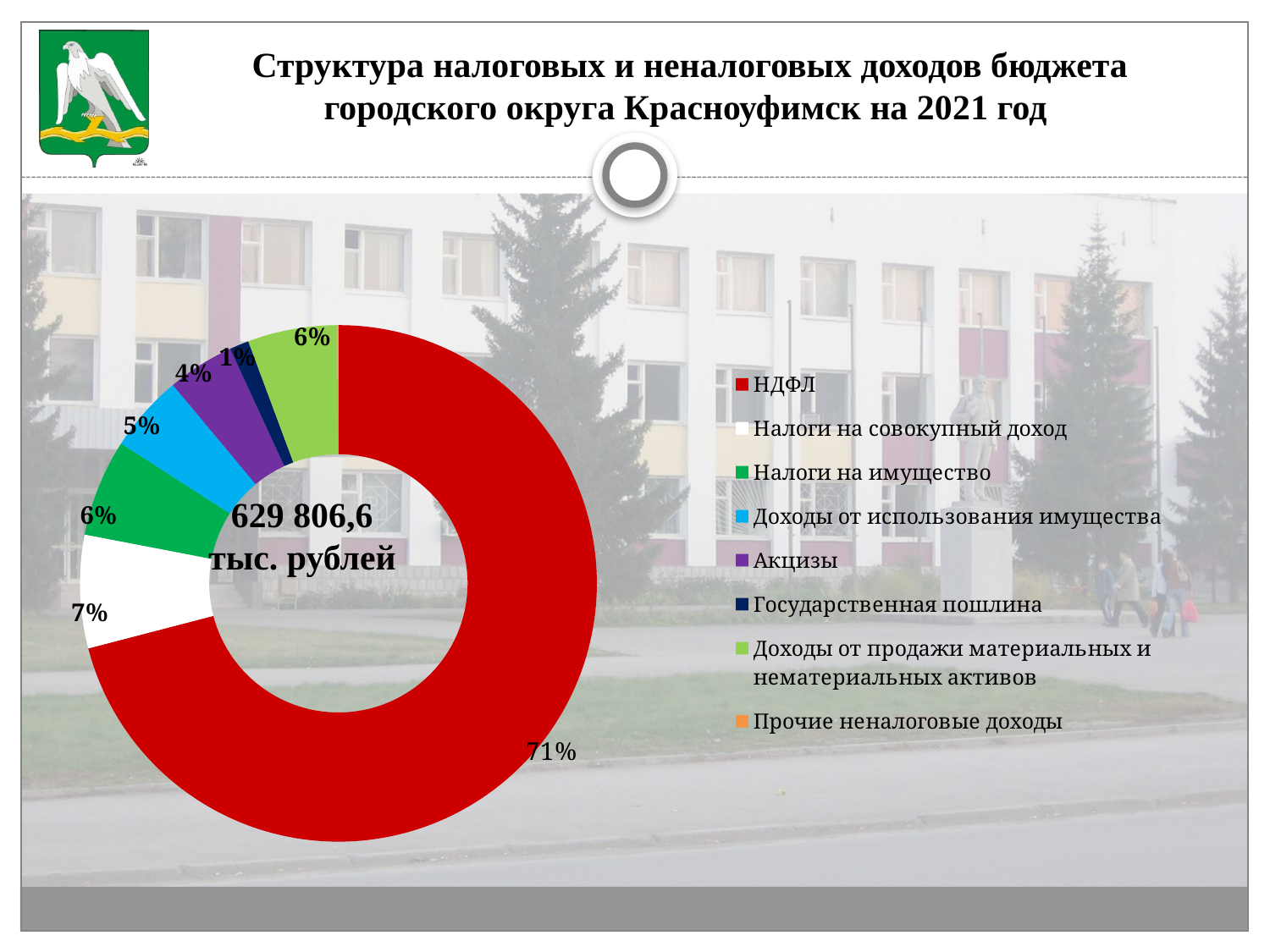
What percentage is shown for Доходы от использования имущества? 5% What share of the chart does НДФЛ account for? 71% Which category has the largest share of the chart? НДФЛ Which is larger: the share for Налоги на совокупный доход or the share for Акцизы? Налоги на совокупный доход What percentage is shown for Налоги на имущество? 6% How many entries does the legend list? 8 What percentage is shown for Акцизы? 4% What percentage is shown for Налоги на совокупный доход? 7% What percentage is shown for Государственная пошлина? 1% What total amount is printed in the centre of the chart? 629 806,6 тыс. рублей What kind of chart is shown on the slide? doughnut chart What is the difference in percentage points between the share for НДФЛ and the share for Налоги на совокупный доход? 64